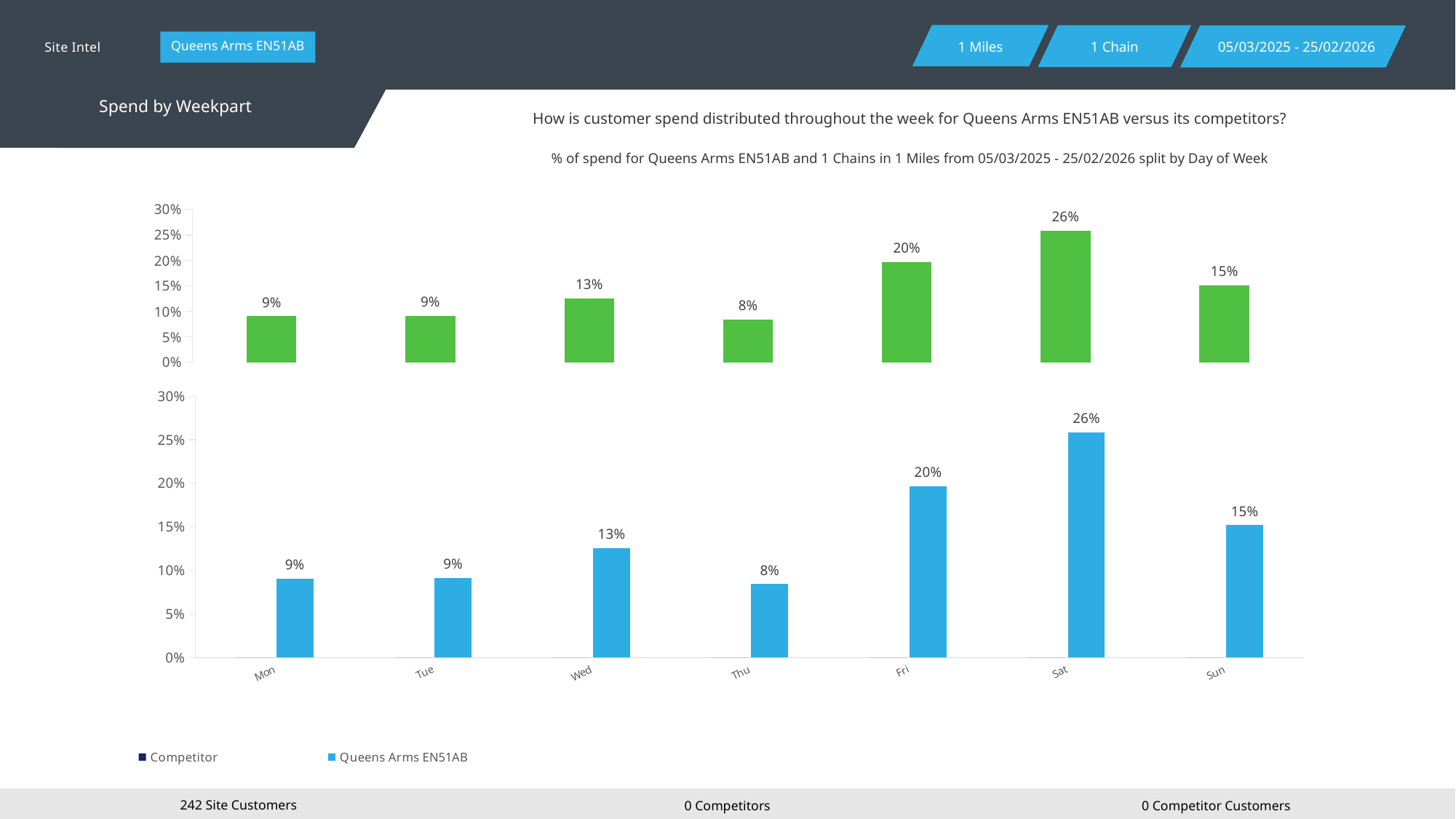
In the bottom chart, which day has the highest value for Queens Arms EN51AB? Sat In the bottom chart, what is the value for Queens Arms EN51AB on Sat? 26% In the bottom chart, what is the value for Queens Arms EN51AB on Thu? 8% How many days of the week are shown on the x axis of the bottom chart? 7 How many series does the legend list? 2 In the bottom chart, is the value for Queens Arms EN51AB on Sat greater or less than 25%? greater What is the highest value labelled in the top chart? 26% In the bottom chart, what is the value for Queens Arms EN51AB on Fri? 20% In the bottom chart, which is larger for Queens Arms EN51AB: Wed or Fri? Fri In the bottom chart, which day has the lowest value for Queens Arms EN51AB? Thu In the bottom chart, what is the difference between the Queens Arms EN51AB values for Sat and Sun? 11% What kind of chart is the top chart? Bar chart